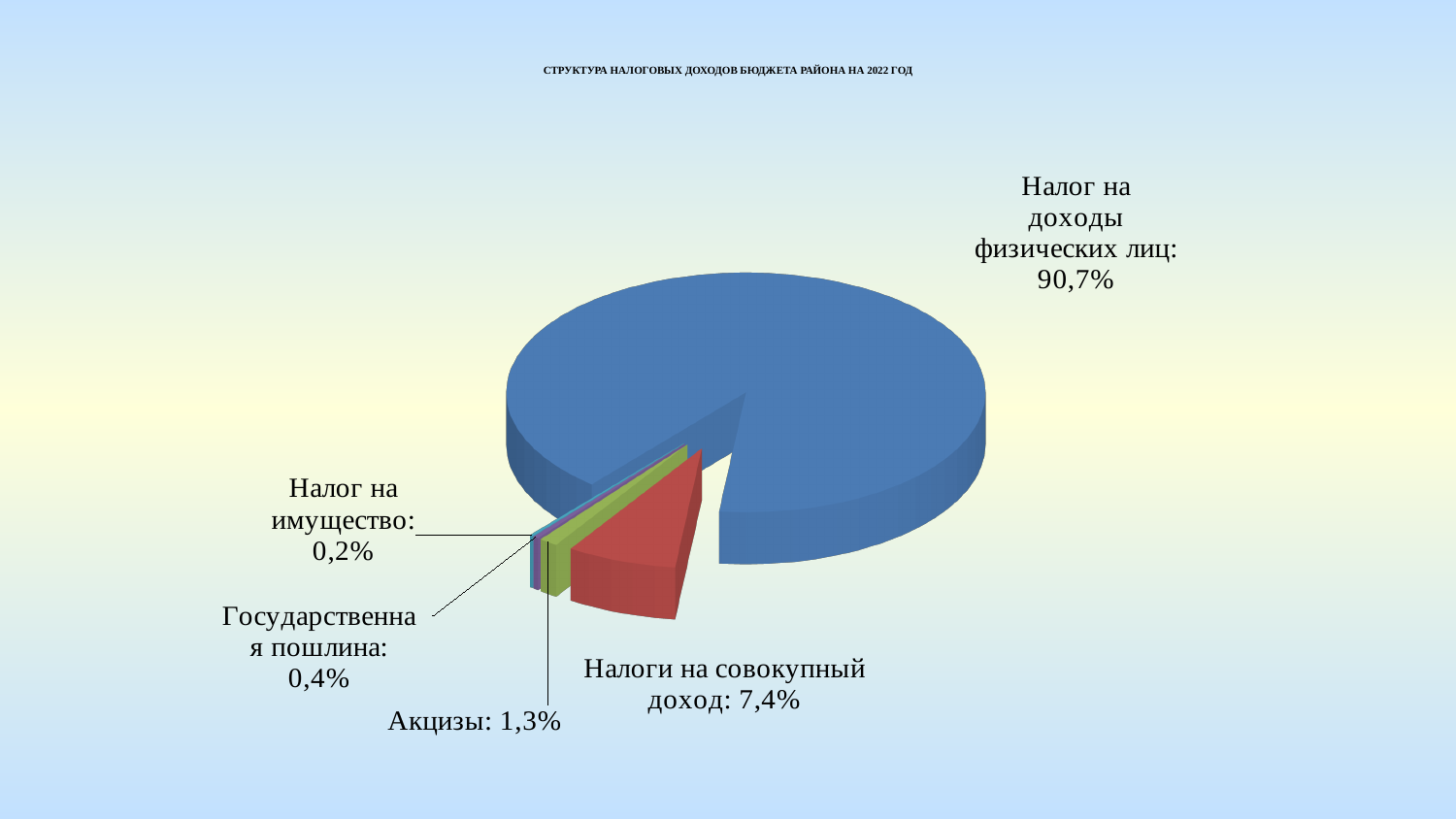
What is the value shown for Государственная пошлина? 0,4% Which category has the smallest share of the pie? Налог на имущество What kind of chart is shown on the slide? Pie chart Which category has the largest share of the pie? Налог на доходы физических лиц What is the value shown for Налоги на совокупный доход? 7,4% What is the value shown for Налог на имущество? 0,2% What is the value shown for Акцизы? 1,3% What share of the pie does Налог на доходы физических лиц represent? 90,7% Which is larger: the share of Акцизы or the share of Государственная пошлина? Акцизы What is the title of the chart? СТРУКТУРА НАЛОГОВЫХ ДОХОДОВ БЮДЖЕТА РАЙОНА НА 2022 ГОД What is the difference between the shares of Налог на доходы физических лиц and Налоги на совокупный доход? 83,3% How many slices does the pie chart have? 5